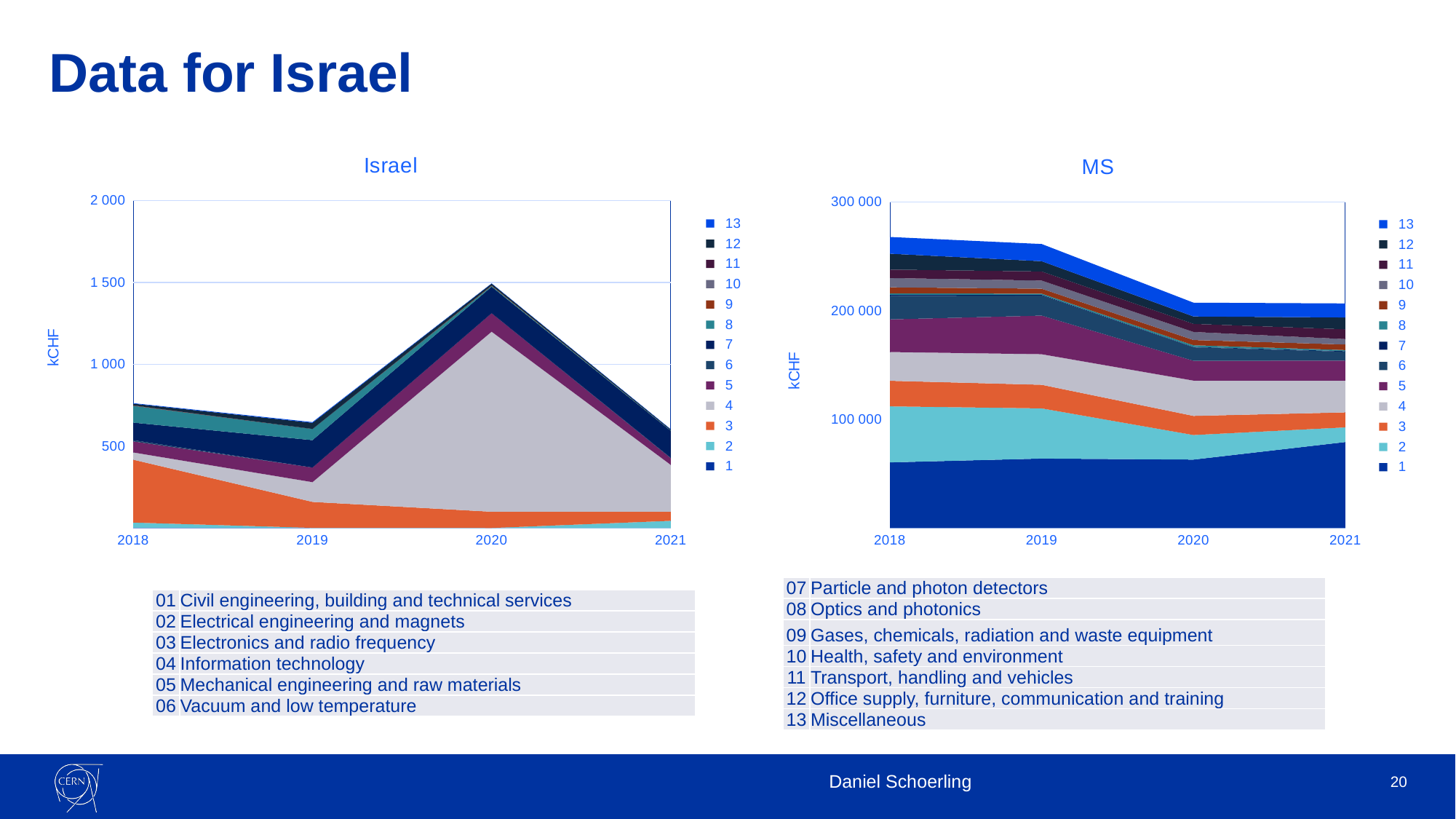
What kind of chart is the chart titled "Israel"? stacked area chart In the "MS" chart, is the total value for 2021 greater or less than 300 000? less How many series does the legend of the "MS" chart list? 13 In the "Israel" chart, is the total value for 2019 greater or less than 1 000? less In the "Israel" chart, which year has the highest total value? 2020 What unit is shown on the y axis of the "MS" chart? kCHF In the "Israel" chart, is the total value for 2018 greater or less than 500? greater How many years are shown on the x axis of the "Israel" chart? 4 In the "Israel" chart, which year has a larger total value, 2020 or 2021? 2020 In the "MS" chart, does the total value rise or fall from 2018 to 2021? fall